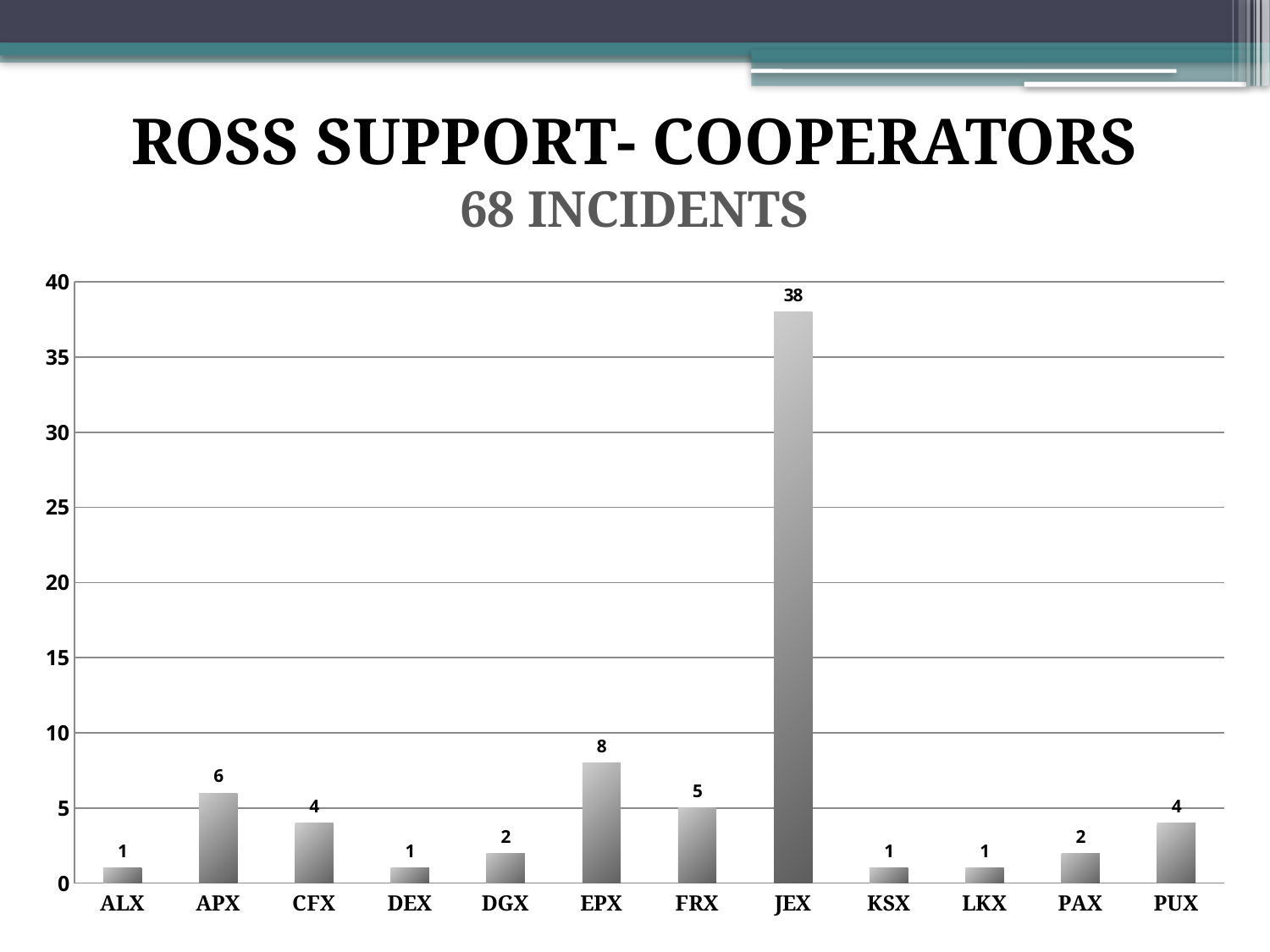
What is the value for EPX? 8 Is the value for JEX greater or less than 35? greater Which is larger, the value for FRX or the value for PUX? FRX What is the title of the chart? ROSS SUPPORT- COOPERATORS 68 INCIDENTS Which category has the highest value? JEX What is the difference between the values for APX and CFX? 2 What kind of chart is shown on the slide? bar chart What is the difference between the values for JEX and EPX? 30 How many categories are shown on the x axis? 12 How many categories have a value of 1? 4 What is the value for JEX? 38 What is the value for APX? 6